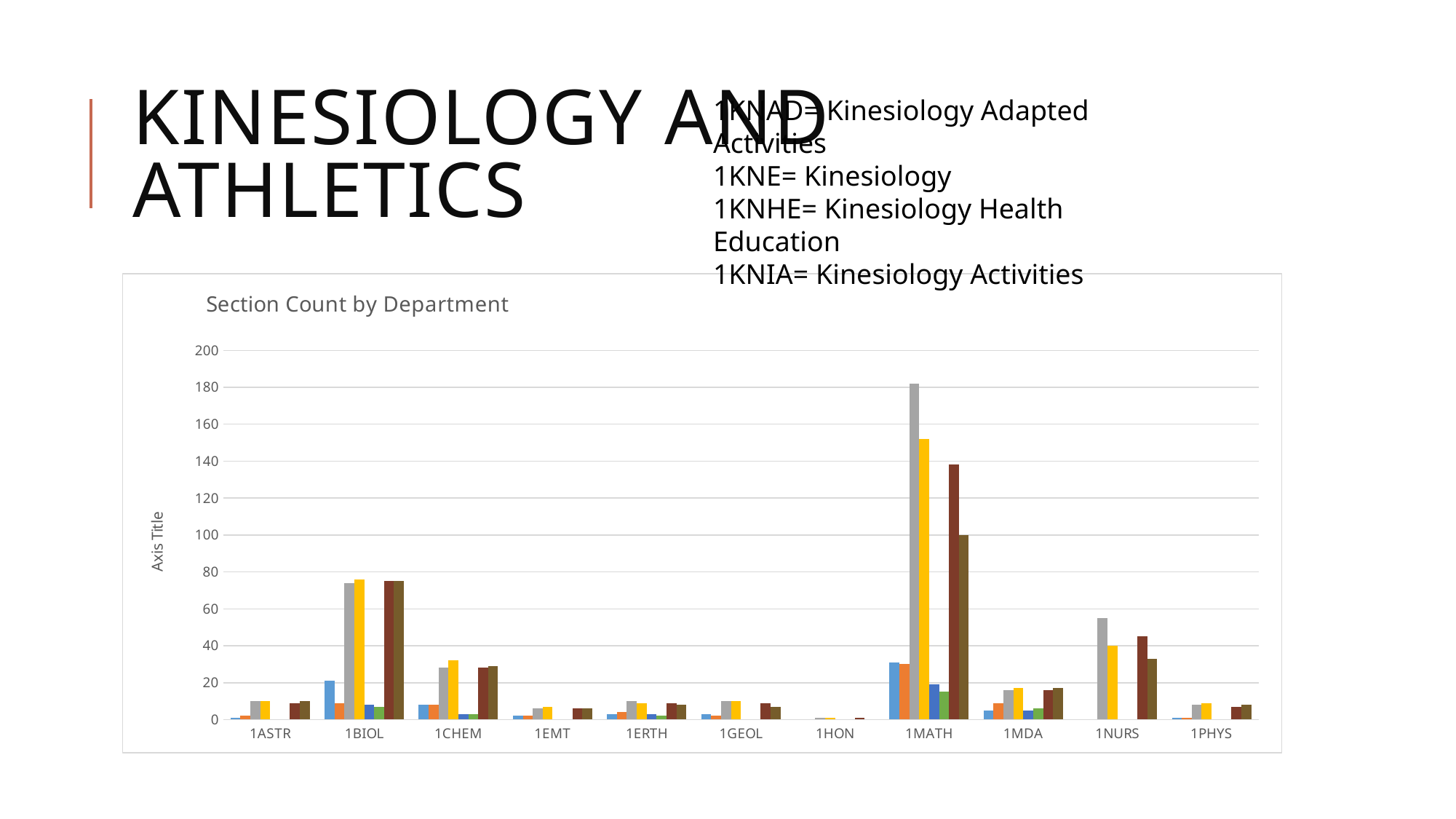
What is the title of the chart on the slide? Section Count by Department Which department has the tallest bar in the chart? 1MATH Is the yellow bar for 1BIOL greater or less than 60? greater Is the yellow bar for 1CHEM greater or less than 40? less Is the gray bar for 1NURS greater or less than 40? greater Which department has a taller gray bar, 1BIOL or 1CHEM? 1BIOL Which department has a taller yellow bar, 1NURS or 1MDA? 1NURS How many departments (categories) are shown on the x axis of the chart? 11 What kind of chart is shown on the slide? bar chart Which department has the smallest bars overall in the chart? 1HON What label is shown on the vertical axis of the chart? Axis Title